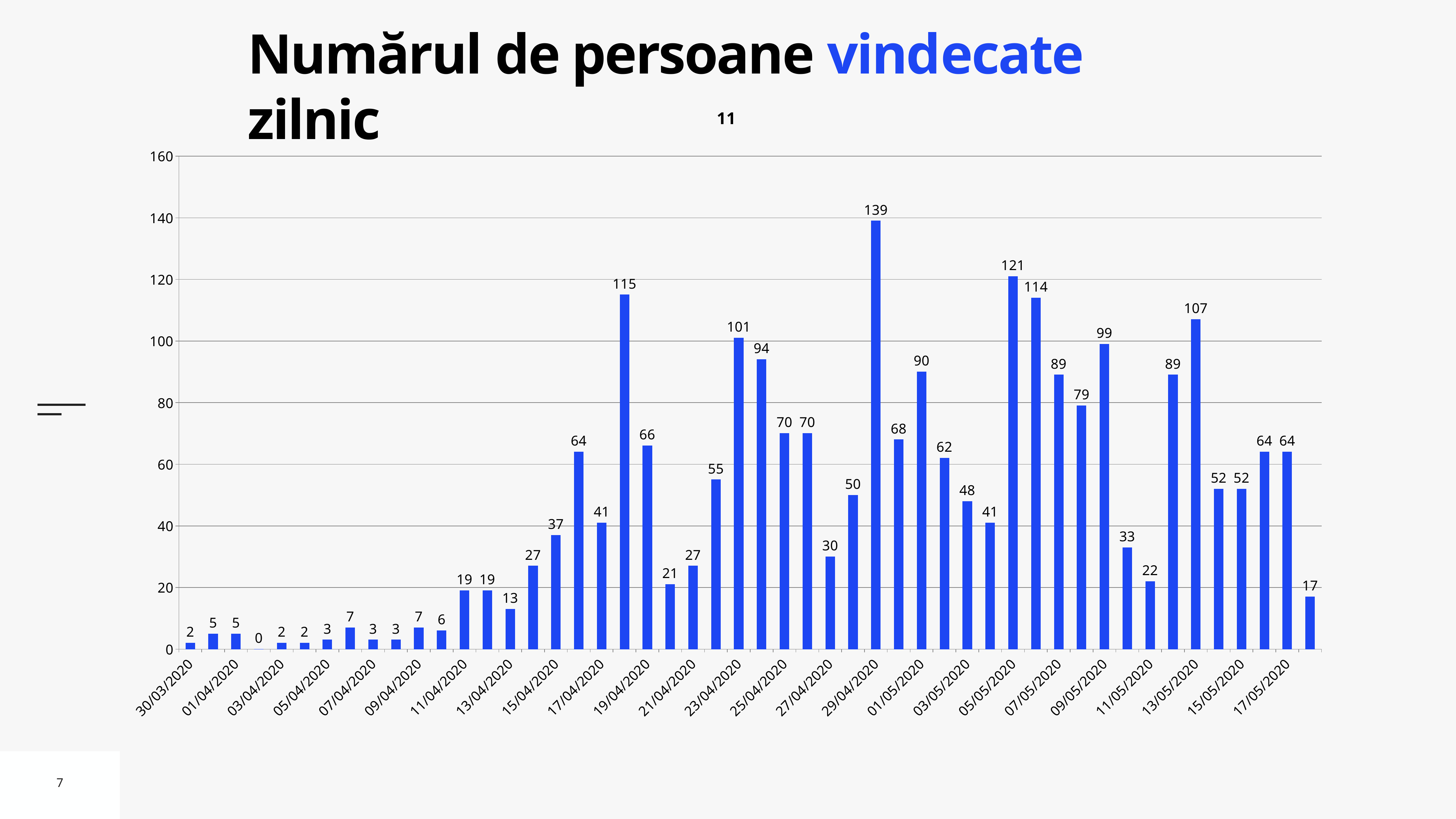
What is the value for 13/05/2020? 107 What is the title of the slide? Numărul de persoane vindecate zilnic What is the lowest value shown on the chart? 0 What is the value for 05/05/2020? 121 Is the value for 13/05/2020 greater or less than 100? greater What is the difference between the values for 29/04/2020 and 05/05/2020? 18 Which is larger, the value for 01/05/2020 or the value for 09/05/2020? 09/05/2020 What is the value for 29/04/2020? 139 Which date has the highest value? 29/04/2020 What is the difference between the values for 13/05/2020 and 11/05/2020? 85 What kind of chart is shown on the slide? bar chart What is the value for 23/04/2020? 101